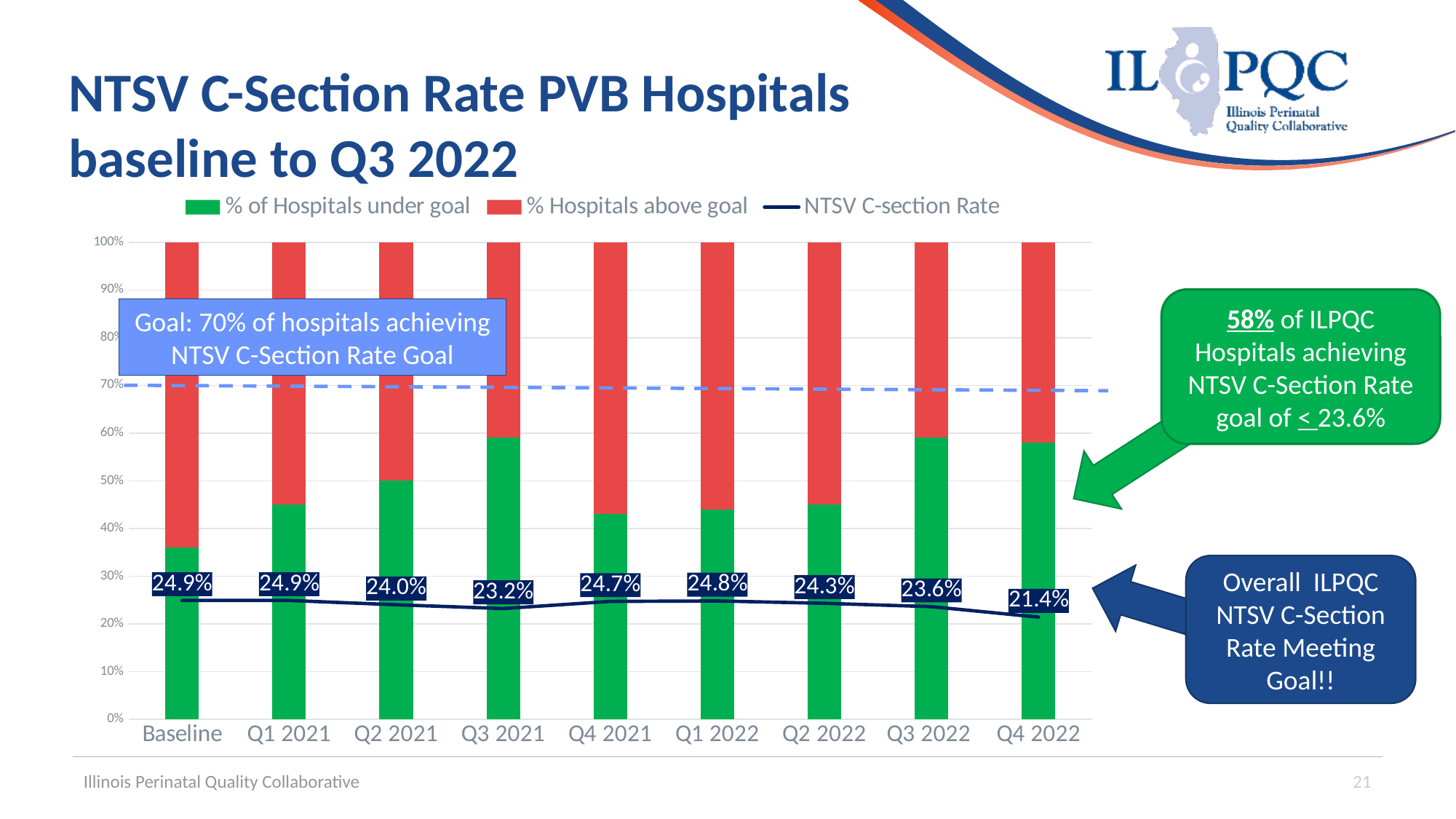
What is the NTSV C-section Rate at Baseline? 24.9% What is the NTSV C-section Rate for Q4 2022? 21.4% Is the % of Hospitals under goal for Q3 2022 greater or less than 50%? greater How many series does the chart legend list? 3 At what percentage is the dashed goal line for hospitals achieving the NTSV C-Section Rate goal drawn? 70% By how many percentage points did the NTSV C-section Rate fall from Baseline to Q4 2022? 3.5 percentage points How many periods are shown on the x axis of the chart? 9 What kind of chart is shown on the slide? A stacked bar chart with a line Which has the higher NTSV C-section Rate, Q4 2021 or Q2 2022? Q4 2021 What is the NTSV C-section Rate for Q3 2021? 23.2% Is the % of Hospitals under goal at Baseline greater or less than 40%? less Which period has the lowest NTSV C-section Rate? Q4 2022